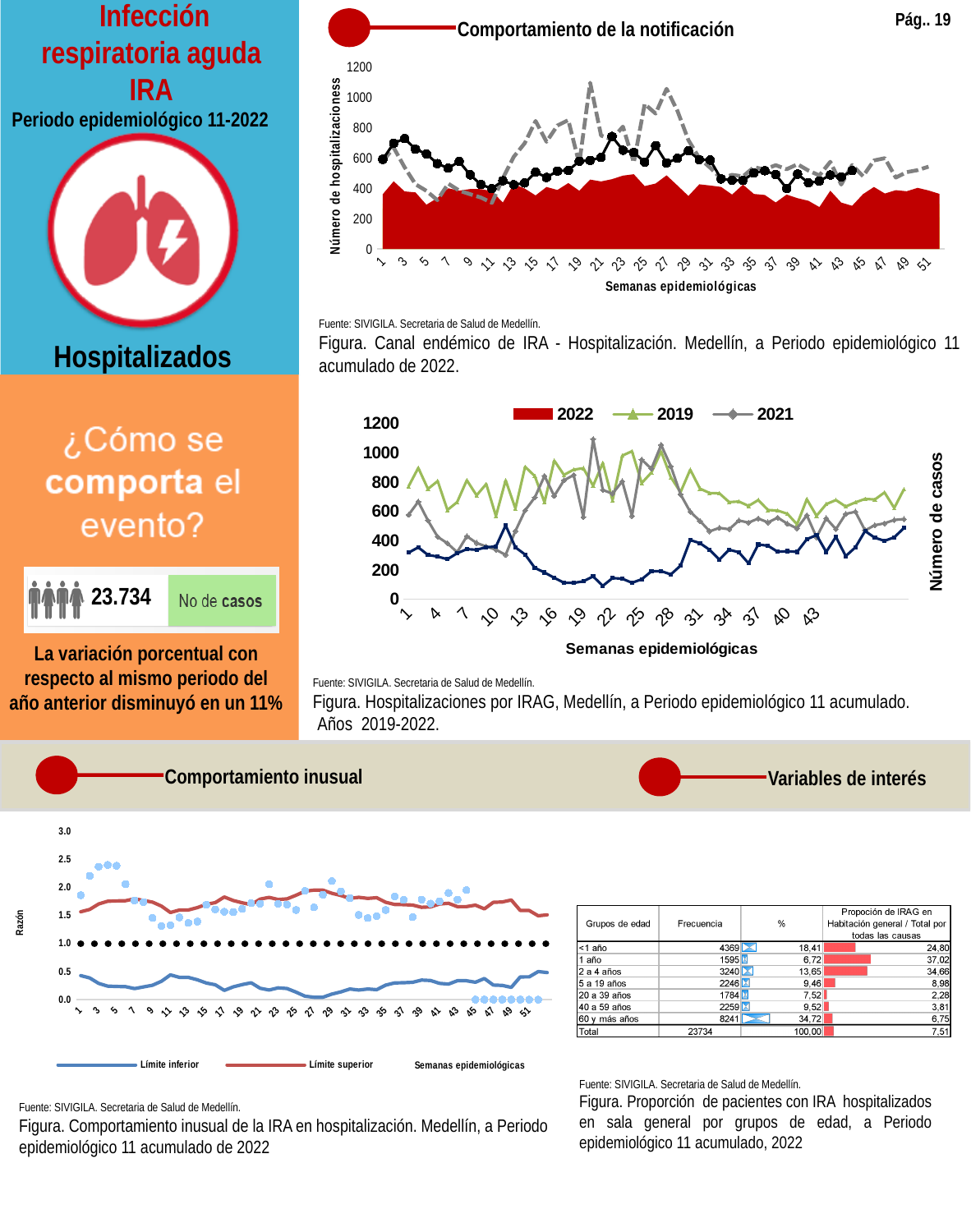
In the table 'Proporción de pacientes con IRA hospitalizados en sala general por grupos de edad' (bottom right), what is the difference in Frecuencia between '60 y más años' and '<1 año'? 3872 In the chart titled 'Hospitalizaciones por IRAG' (middle right), what kind of chart is it? Line chart In the table 'Proporción de pacientes con IRA hospitalizados en sala general por grupos de edad' (bottom right), what is the Frecuencia for '60 y más años'? 8241 In the chart titled 'Comportamiento inusual de la IRA en hospitalización' (bottom left), what is the label of the vertical axis? Razón In the table 'Proporción de pacientes con IRA hospitalizados en sala general por grupos de edad' (bottom right), which age group has the lowest Frecuencia? 1 año In the chart titled 'Hospitalizaciones por IRAG' (middle right), what is the label of the vertical axis? Número de casos In the chart titled 'Hospitalizaciones por IRAG' (middle right), is the 2019 value at week 1 greater or less than 600? greater In the table 'Proporción de pacientes con IRA hospitalizados en sala general por grupos de edad' (bottom right), which age group has the highest Frecuencia? 60 y más años In the chart titled 'Comportamiento inusual de la IRA en hospitalización' (bottom left), how many series does the legend list? 2 In the chart titled 'Hospitalizaciones por IRAG' (middle right), how many series does the legend list? 3